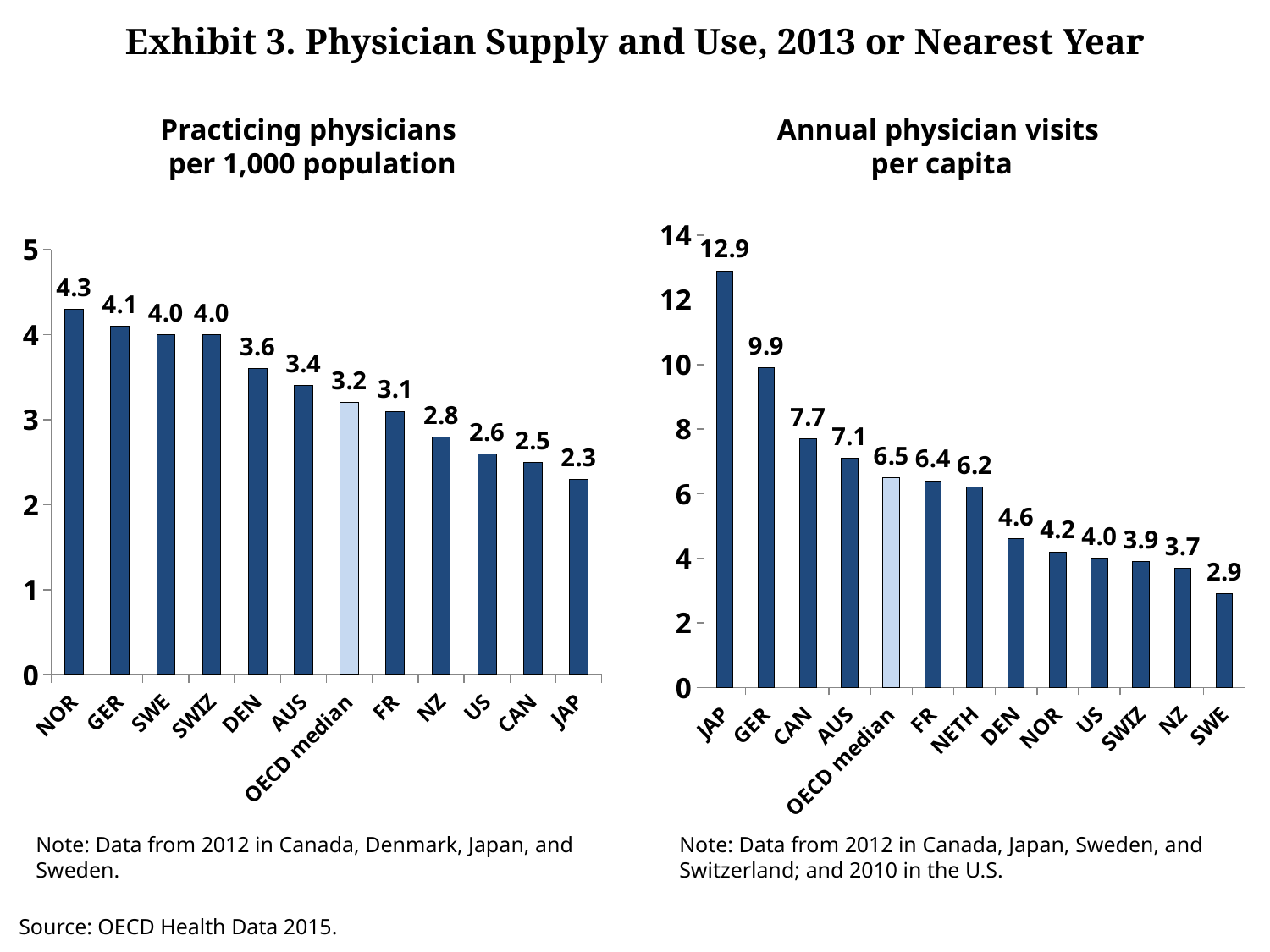
In the 'Annual physician visits per capita' chart, is the value for CAN greater or less than 6? greater In the 'Annual physician visits per capita' chart, what is the value for the OECD median? 6.5 In the 'Annual physician visits per capita' chart, do the values rise or fall from left to right? Fall How many countries or categories are shown in the 'Annual physician visits per capita' chart? 13 In the 'Practicing physicians per 1,000 population' chart, what is the difference between the US and the OECD median? 0.6 In the 'Annual physician visits per capita' chart, which country has the highest value? JAP How many categories are shown in the 'Practicing physicians per 1,000 population' chart? 12 In the 'Annual physician visits per capita' chart, what is the difference between JAP and GER? 3.0 In the 'Practicing physicians per 1,000 population' chart, which country has the lowest value? JAP What type of chart is the 'Practicing physicians per 1,000 population' chart? Bar chart In the 'Practicing physicians per 1,000 population' chart, what is the value for NOR? 4.3 In the 'Practicing physicians per 1,000 population' chart, which is larger, DEN or AUS? DEN